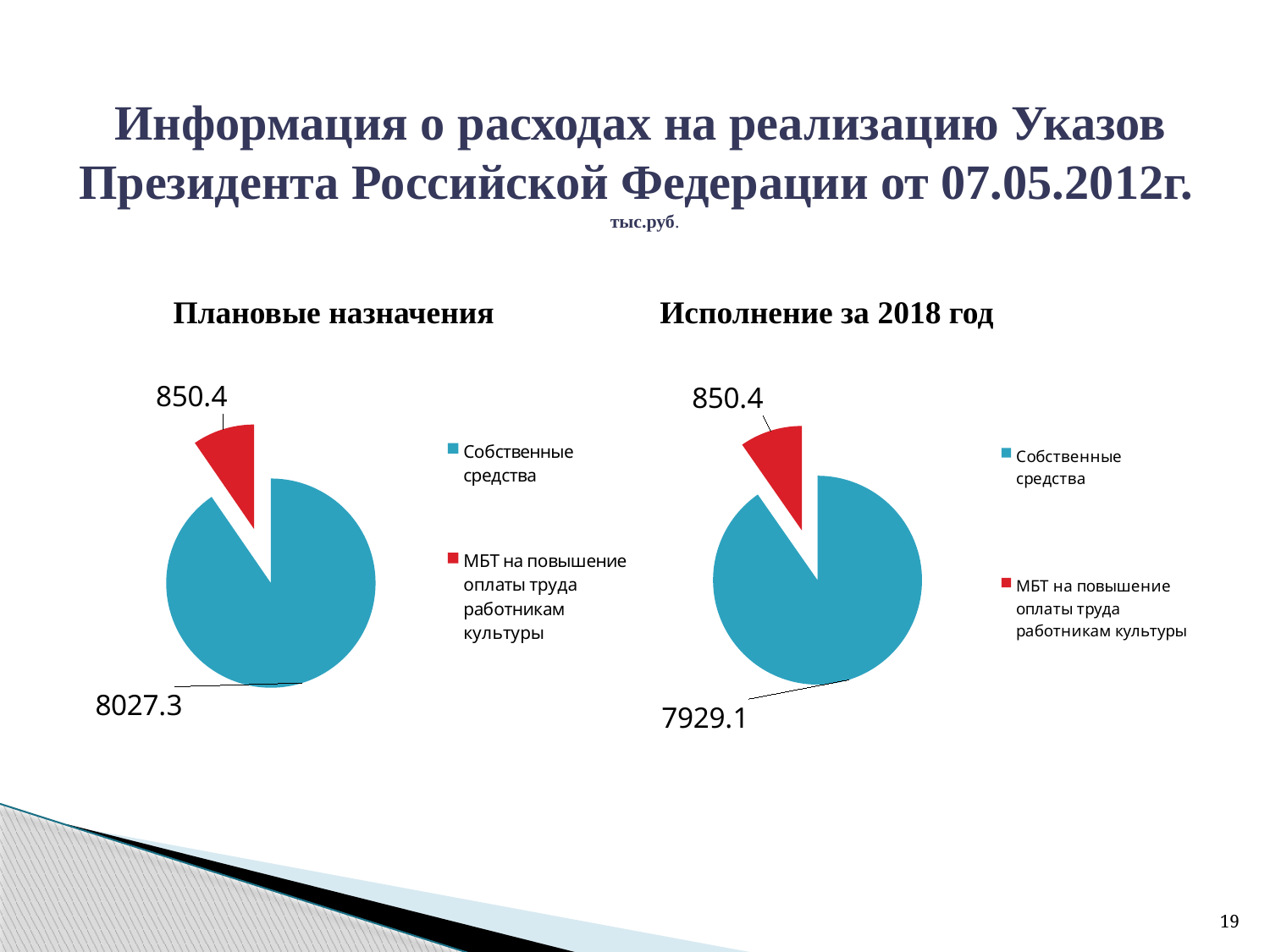
What kind of chart is the 'Плановые назначения' chart? Pie chart How many slices does the 'Исполнение за 2018 год' pie chart have? 2 Which is larger: Собственные средства in the 'Плановые назначения' chart or in the 'Исполнение за 2018 год' chart? Плановые назначения In the 'Исполнение за 2018 год' chart, what is the value for Собственные средства? 7929.1 What is the difference between the Собственные средства value in the 'Плановые назначения' chart and in the 'Исполнение за 2018 год' chart? 98.2 What colour is the Собственные средства slice in the 'Плановые назначения' chart? Blue In the 'Исполнение за 2018 год' chart, what is the value for МБТ на повышение оплаты труда работникам культуры? 850.4 In the 'Плановые назначения' chart, what is the value for Собственные средства? 8027.3 In the 'Плановые назначения' chart, which category has the smallest slice? МБТ на повышение оплаты труда работникам культуры In the 'Плановые назначения' chart, what is the difference between Собственные средства and МБТ на повышение оплаты труда работникам культуры? 7176.9 In the 'Плановые назначения' chart, what is the value for МБТ на повышение оплаты труда работникам культуры? 850.4 In the 'Исполнение за 2018 год' chart, which category has the largest slice? Собственные средства